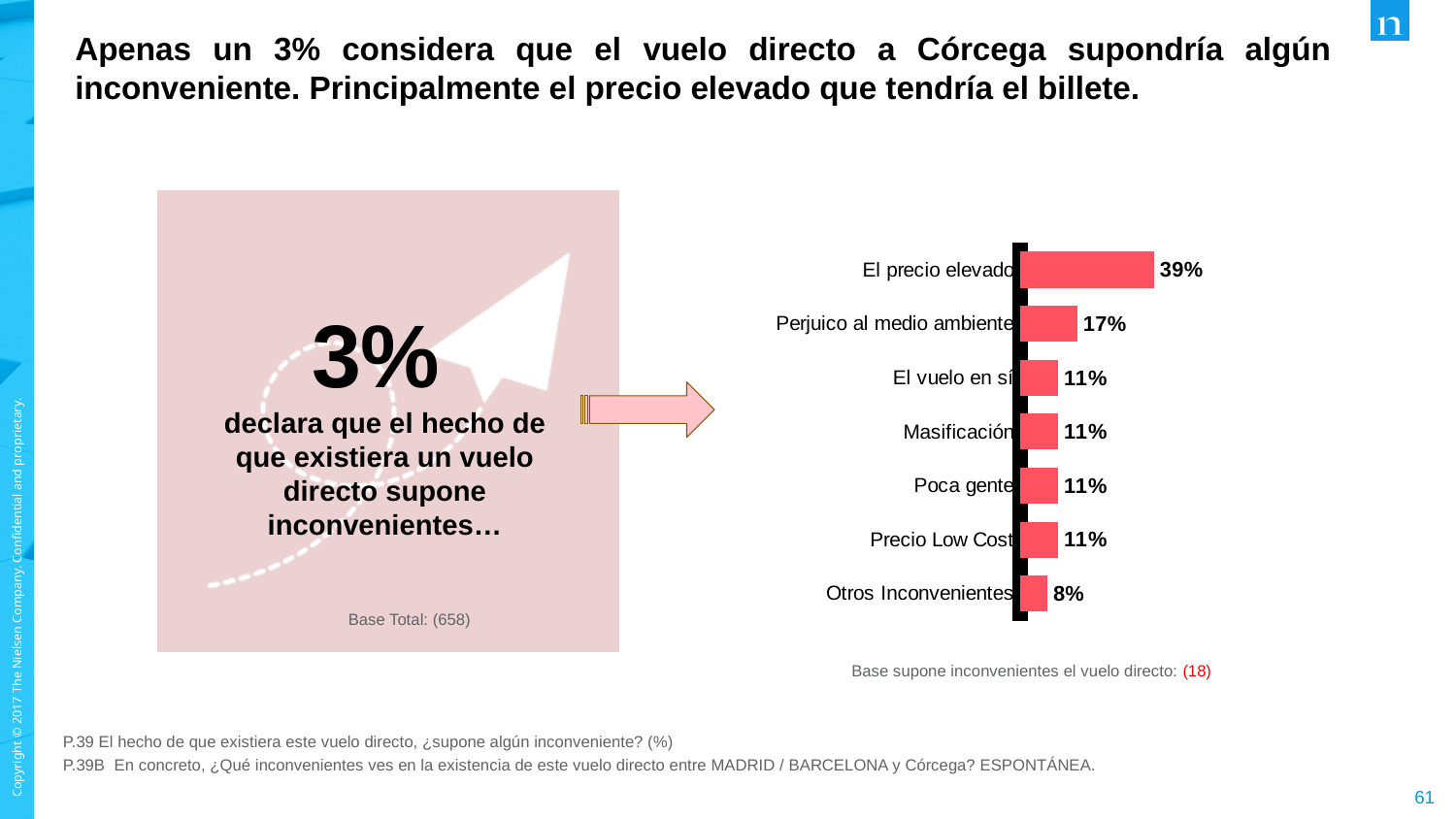
What is the value for Masificación? 11% What is the difference between El precio elevado and Perjuico al medio ambiente? 22% What is the difference between Perjuico al medio ambiente and Otros Inconvenientes? 9% How many categories are shown in the bar chart? 7 What kind of chart is shown on the slide? bar chart What is the value for El precio elevado? 39% Which category has the lowest value? Otros Inconvenientes What is the value for Otros Inconvenientes? 8% How many categories share the value 11%? 4 Which is larger, El precio elevado or El vuelo en sí? El precio elevado Which category has the highest value? El precio elevado What is the value for Perjuico al medio ambiente? 17%